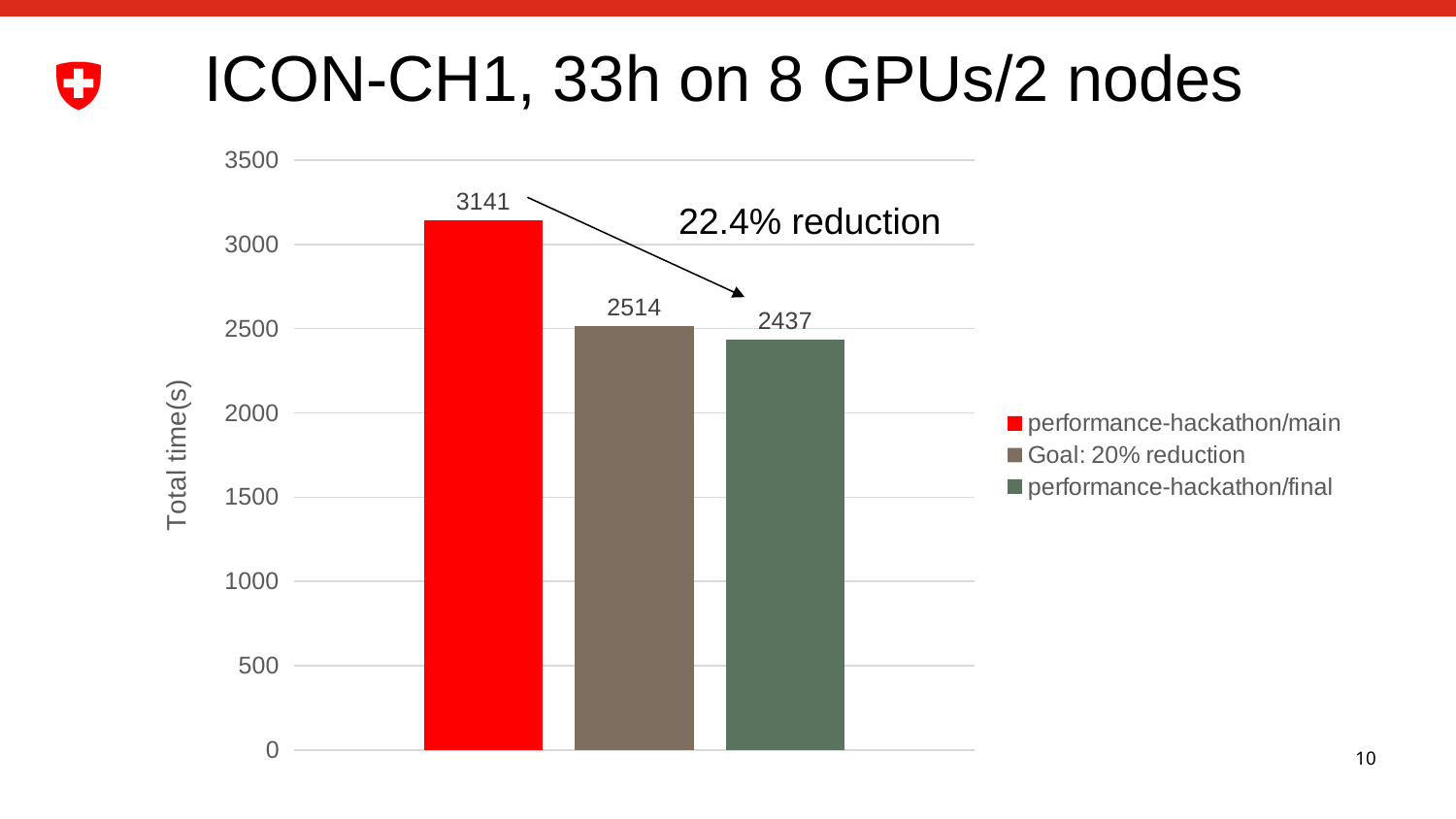
What is the difference in total time between Goal: 20% reduction and performance-hackathon/final? 77 What percentage reduction is annotated on the chart? 22.4% reduction What is the total time for Goal: 20% reduction? 2514 What is the total time for performance-hackathon/main? 3141 Which is larger, the total time for performance-hackathon/main or for Goal: 20% reduction? performance-hackathon/main What is the difference in total time between performance-hackathon/main and performance-hackathon/final? 704 Is the value for performance-hackathon/final greater or less than 2500? less How many series does the legend list? 3 What is the total time for performance-hackathon/final? 2437 Which series has the highest total time? performance-hackathon/main What kind of chart is shown on the slide? bar chart Which series has the lowest total time? performance-hackathon/final